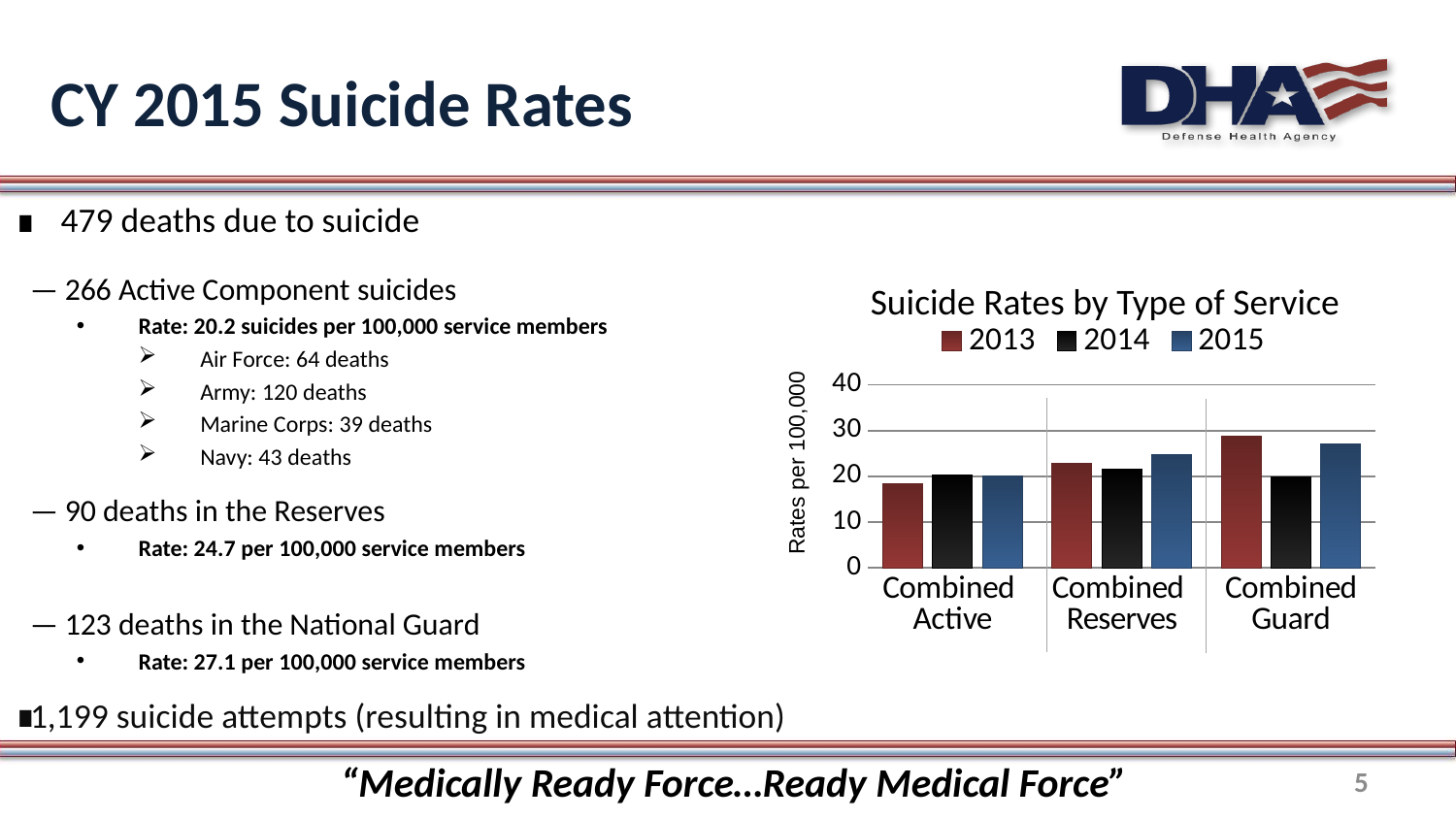
Which category has the lowest 2013 value? Combined Active Is the 2013 value for Combined Active greater or less than 20? less Which is larger: the 2015 value for Combined Reserves or the 2015 value for Combined Active? Combined Reserves Is the 2015 value for Combined Reserves greater or less than 30? less For Combined Guard, which is larger: the 2013 value or the 2014 value? 2013 How many series does the legend of the chart list? 3 How many categories are shown on the x axis of the chart? 3 What kind of chart is shown on the slide? bar chart What are the legend entries of the chart? 2013, 2014, 2015 What is the title of the chart? Suicide Rates by Type of Service Which category has the highest 2013 value? Combined Guard Is the 2013 value for Combined Guard greater or less than 20? greater